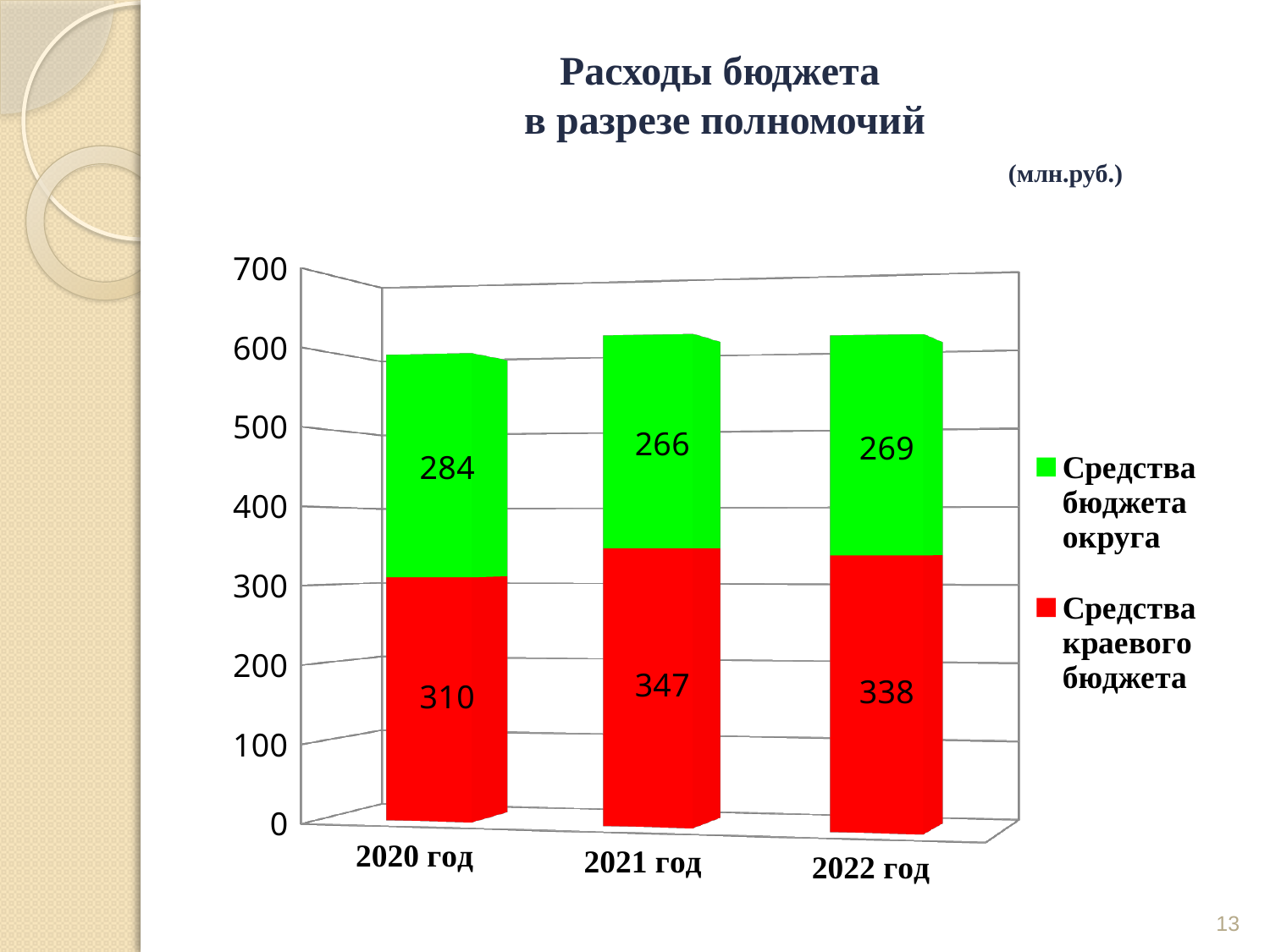
What is the value for Средства бюджета округа in 2021 год? 266 Which is larger in 2022 год: Средства краевого бюджета or Средства бюджета округа? Средства краевого бюджета What is the value for Средства краевого бюджета in 2020 год? 310 What is the total of the stacked bar for 2020 год? 594 What kind of chart is shown on the slide? Stacked bar chart How many years are shown on the x axis? 3 What is the value for Средства бюджета округа in 2022 год? 269 How many series does the legend list? 2 What is the total of the stacked bar for 2021 год? 613 What is the difference between Средства краевого бюджета in 2021 год and 2020 год? 37 In which year is Средства бюджета округа the lowest? 2021 год In which year is Средства краевого бюджета the highest? 2021 год